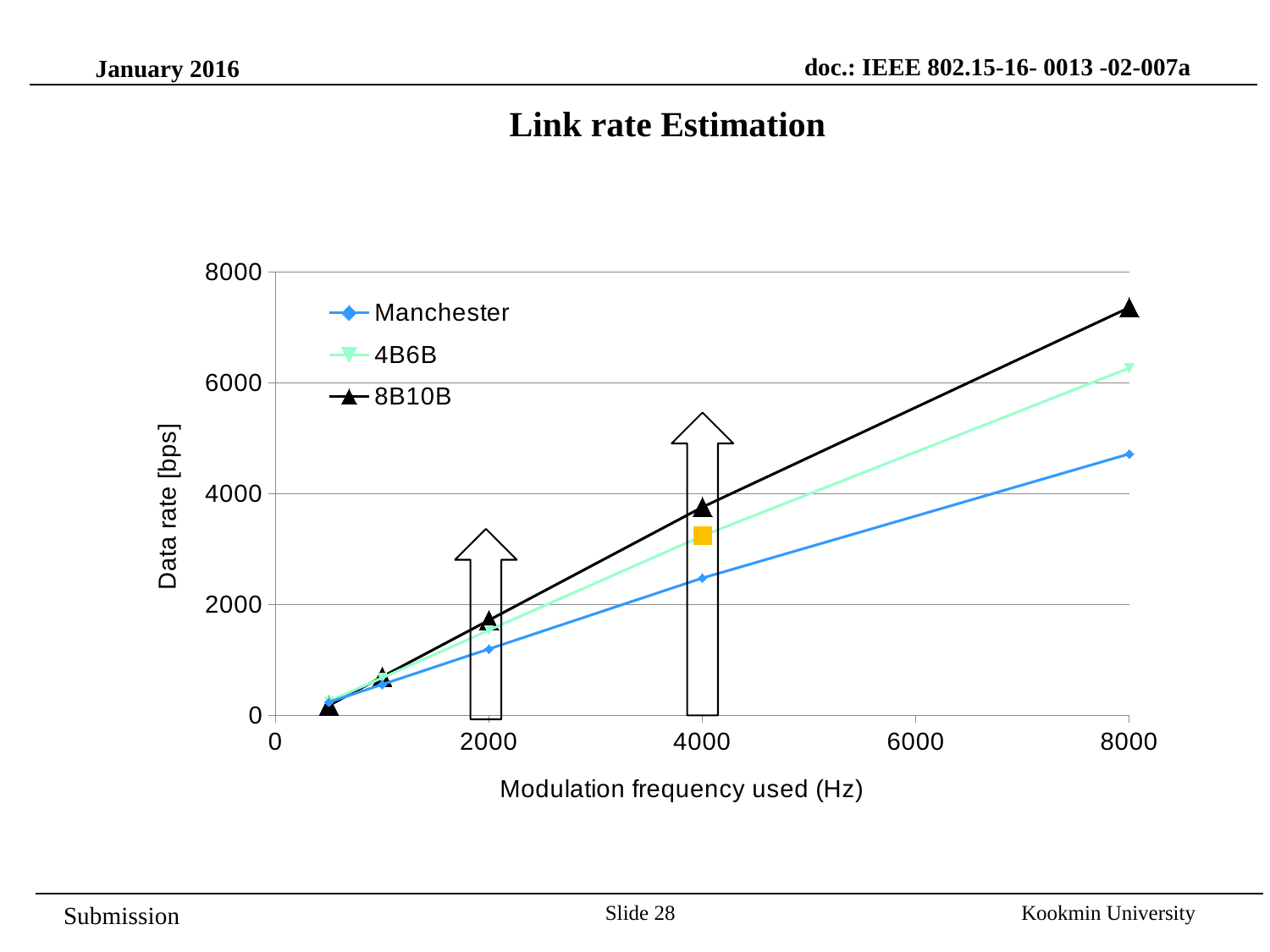
Is the data rate for 8B10B at 8000 Hz greater or less than 6000? greater How many data points are plotted for the 8B10B series? 5 Which series are listed in the legend? Manchester, 4B6B, 8B10B Which series has the highest data rate at 8000 Hz? 8B10B Is the data rate for Manchester at 8000 Hz greater or less than 6000? less Is the data rate for Manchester at 2000 Hz greater or less than 2000? less Do the data rates rise or fall as the modulation frequency increases? rise How many series does the legend list? 3 At 4000 Hz, which series has the larger data rate, Manchester or 8B10B? 8B10B What kind of chart is shown on the slide? line chart What is the label of the x axis? Modulation frequency used (Hz) Which series has the lowest data rate at 8000 Hz? Manchester